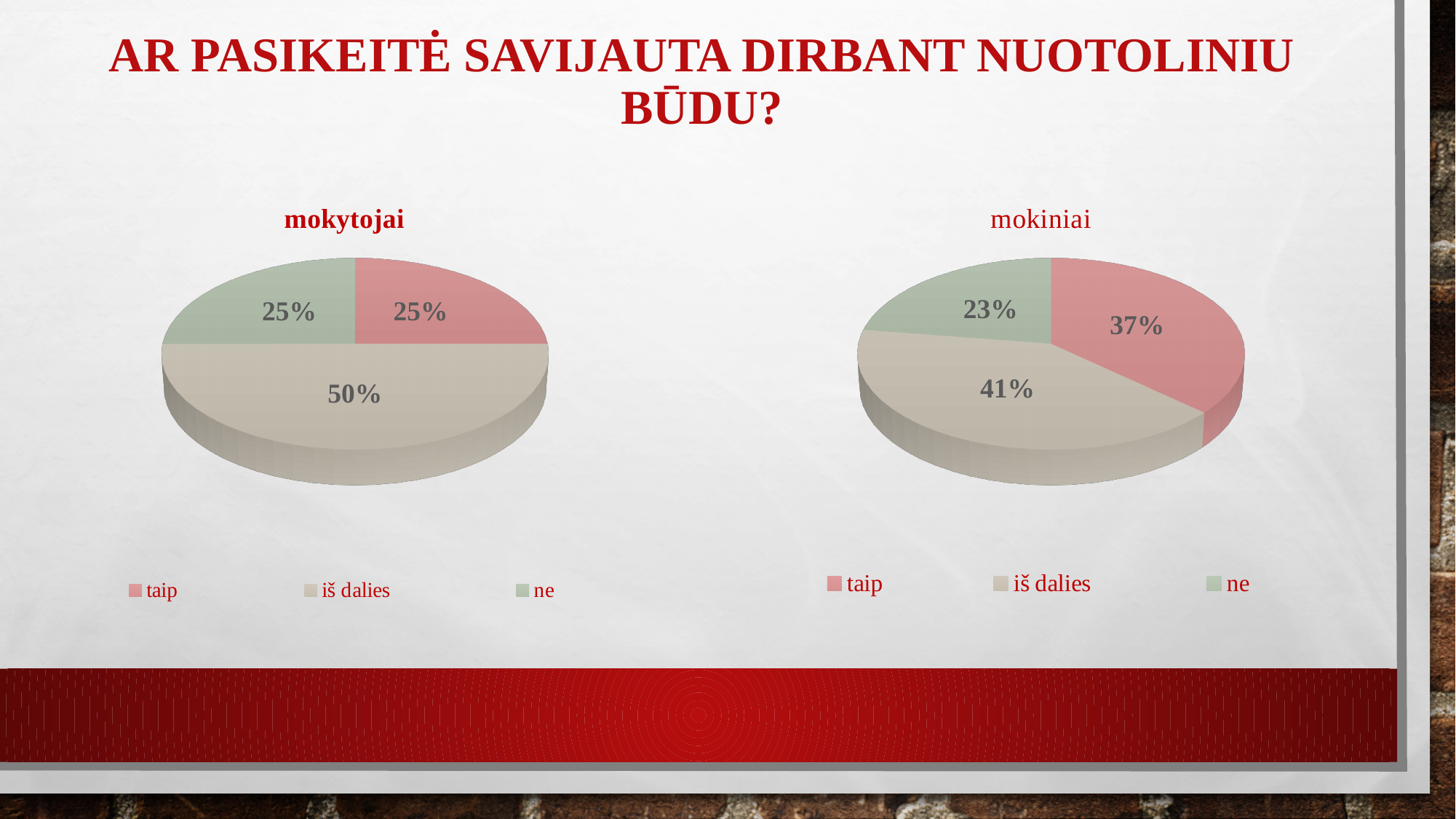
In the "mokytojai" pie chart, what share is labelled for "iš dalies"? 50% How many slices does the "mokytojai" pie chart have? 3 How many entries does the legend of the "mokiniai" chart list? 3 In the "mokiniai" pie chart, what share is labelled for "ne"? 23% In the "mokytojai" pie chart, what share is labelled for "taip"? 25% What type of chart is used for "mokiniai"? pie chart In the "mokiniai" pie chart, which is larger, "taip" or "ne"? taip In the "mokiniai" pie chart, which category has the largest slice? iš dalies In the "mokiniai" pie chart, which category has the smallest slice? ne In the "mokiniai" pie chart, what is the difference between the "iš dalies" and "taip" shares? 4% In the "mokytojai" pie chart, which category has the largest slice? iš dalies In the "mokiniai" pie chart, what share is labelled for "taip"? 37%